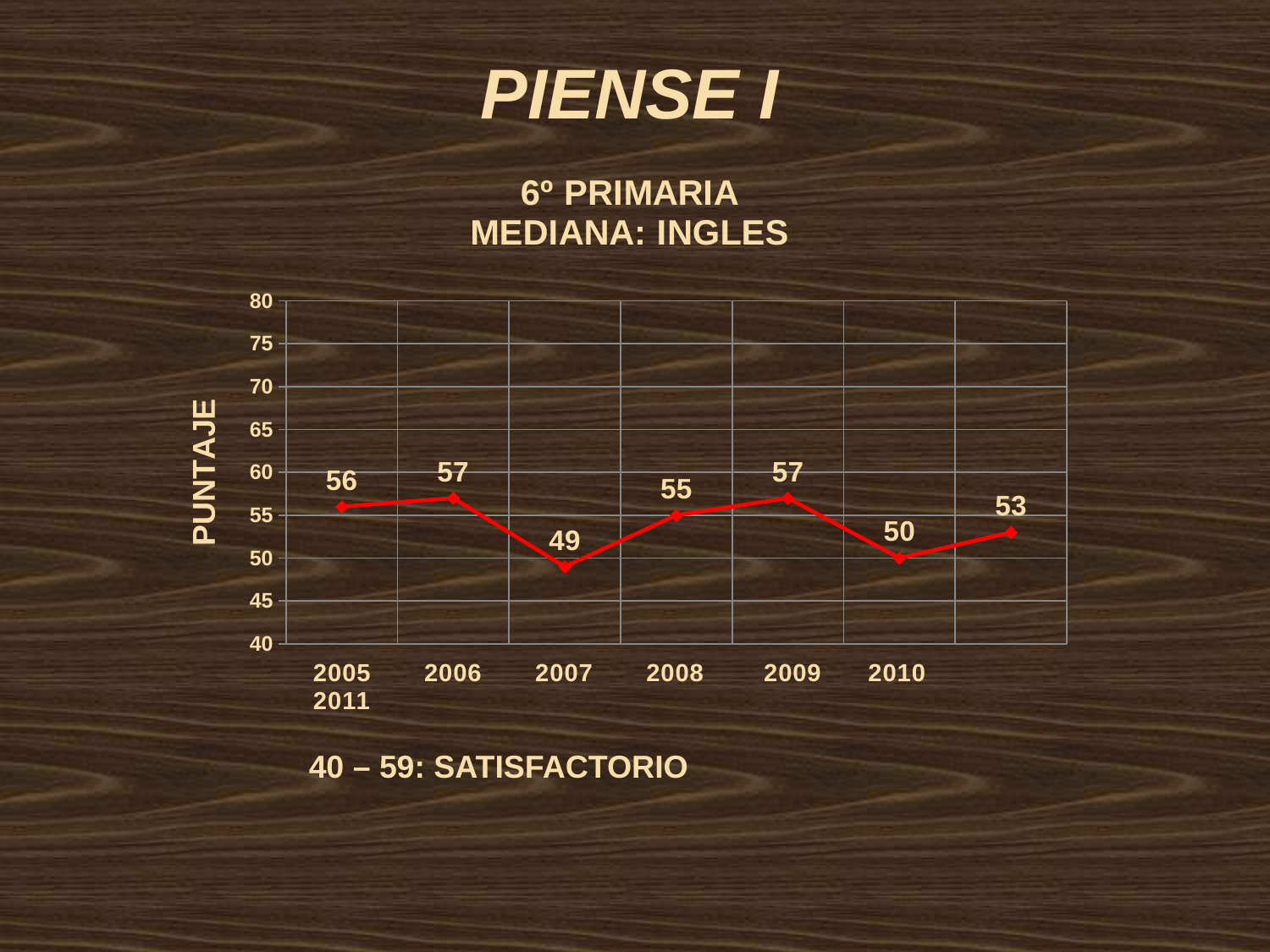
What is the value for 2005? 56 What is the value for 2010? 50 Which year has the lowest value? 2007 What is the value of the last (rightmost) point on the line? 53 How many data points are plotted on the line? 7 What is the label of the vertical axis? PUNTAJE What is the difference between the values for 2006 and 2007? 8 What is the value for 2007? 49 Which is larger, the value for 2008 or the value for 2010? 2008 What is the value for 2008? 55 What type of chart is shown on the slide? line chart What is the difference between the values for 2009 and 2010? 7